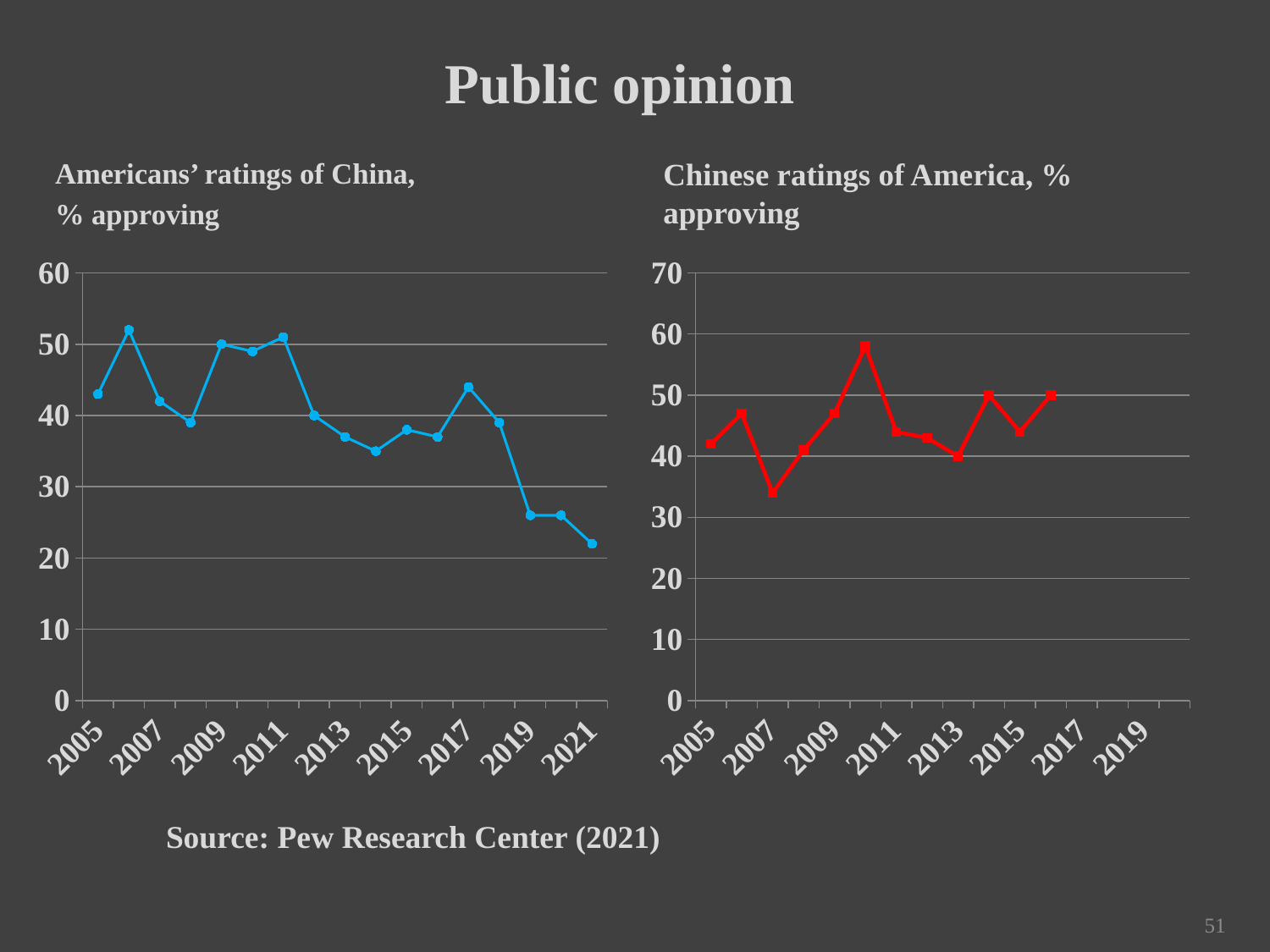
In the 'Americans' ratings of China' chart, which is larger, the value for 2017 or the value for 2019? 2017 In the 'Chinese ratings of America, % approving' chart, which year has the lowest value? 2007 In the 'Americans' ratings of China' chart, is the value for 2006 greater or less than 50? greater What kind of chart is used for 'Americans' ratings of China, % approving'? Line chart In the 'Chinese ratings of America' chart, is the value for 2010 greater or less than 50? greater What colour is the line in the 'Chinese ratings of America, % approving' chart? Red In the 'Americans' ratings of China' chart, is the value for 2021 greater or less than 30? less In the 'Chinese ratings of America' chart, which is larger, the value for 2009 or the value for 2013? 2009 In the 'Americans' ratings of China' chart, do the values overall rise or fall from 2005 to 2021? Fall In the 'Chinese ratings of America, % approving' chart, which year has the highest value? 2010 In the 'Americans' ratings of China' chart, which year has the lowest value? 2021